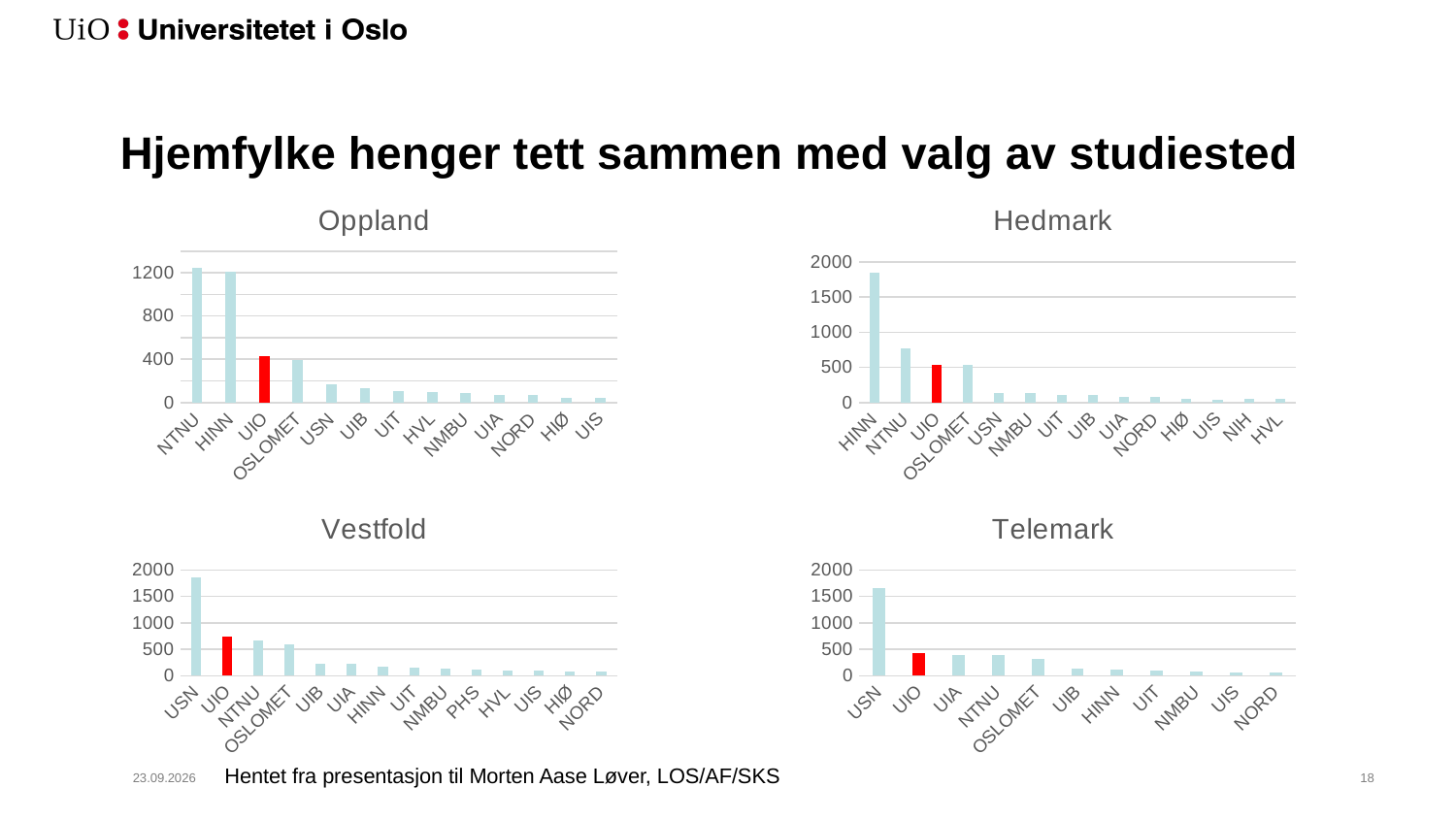
What kind of chart is the Oppland chart? bar chart In the Telemark chart, which is larger, the value for UIO or the value for UIB? UIO In the Vestfold chart, which category has the highest value? USN In the Hedmark chart, is the value for HINN greater or less than 1500? greater In the Oppland chart, how many categories are shown on the x axis? 13 In the Oppland chart, which category's bar is coloured red? UIO In the Vestfold chart, is the value for UIO greater or less than 500? greater How many charts are shown on the slide? 4 In the Hedmark chart, which category has the highest value? HINN In the Hedmark chart, is the value for NTNU greater or less than 500? greater In the Telemark chart, how many categories are shown on the x axis? 11